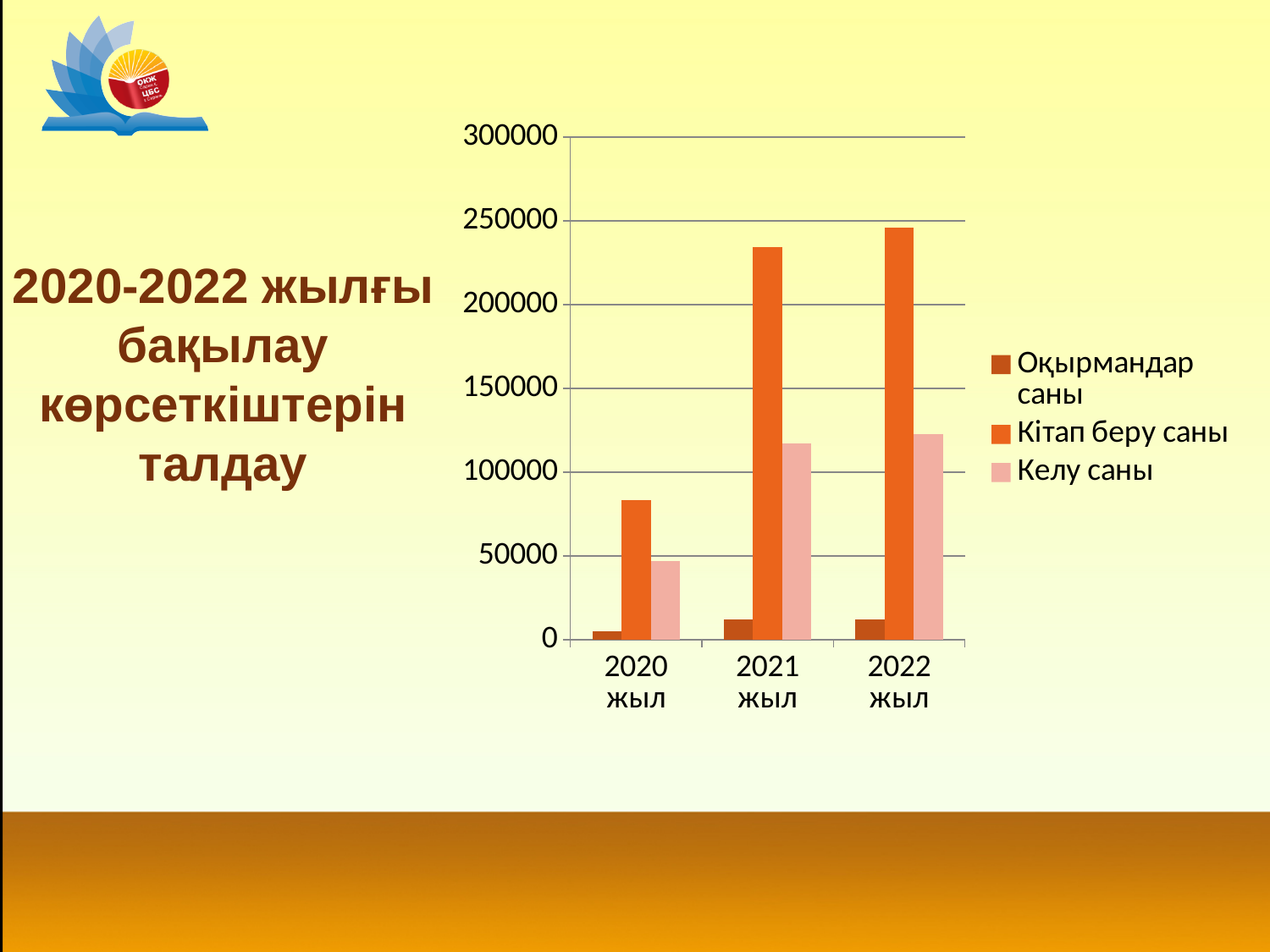
Which series in the legend is shown in the darkest brown colour? Оқырмандар саны Is the value for Келу саны in 2022 жыл greater or less than 100000? greater Do the values for Кітап беру саны rise or fall from 2020 жыл to 2022 жыл? rise How many year categories are shown on the x axis of the chart? 3 Is the value for Кітап беру саны in 2020 жыл greater or less than 100000? less Is the value for Кітап беру саны in 2021 жыл greater or less than 200000? greater What kind of chart is shown on the slide? bar chart Which year has the lowest value for Кітап беру саны? 2020 жыл Which year has the lowest value for Келу саны? 2020 жыл In 2021 жыл, which is larger: Кітап беру саны or Келу саны? Кітап беру саны How many series does the chart legend list? 3